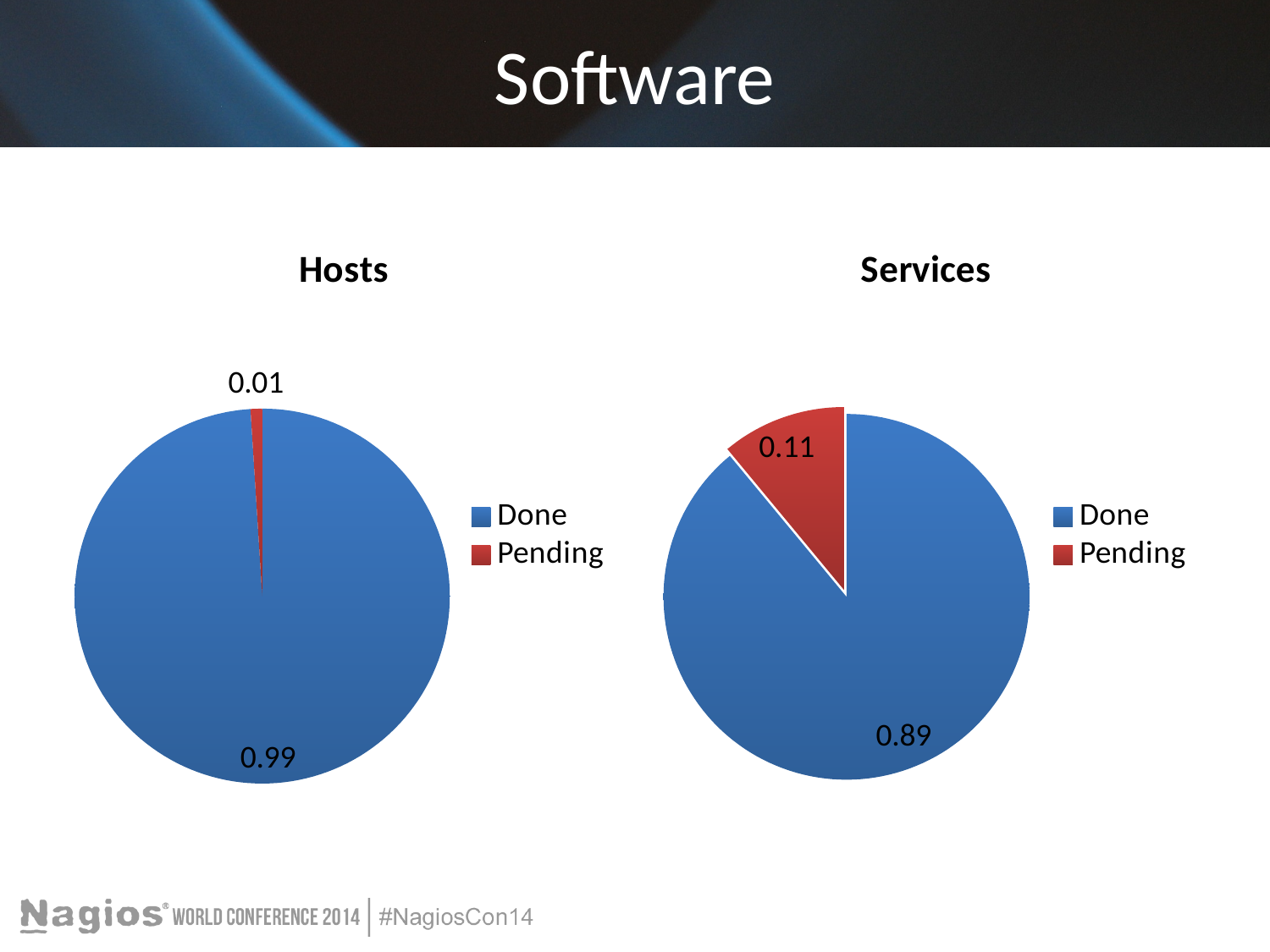
In the Services chart, what is the value for Pending? 0.11 In the Services chart, which category has the largest slice? Done What are the two legend entries in the Services chart? Done and Pending In the Services chart, what is the difference between the Done and Pending values? 0.78 Is the Pending value larger in the Hosts chart or the Services chart? Services In the Services chart, what is the value for Done? 0.89 In the Hosts chart, what is the value for Pending? 0.01 In the Hosts chart, which category has the smallest slice? Pending How many categories does the Services chart show? 2 In the Hosts chart, what is the value for Done? 0.99 In the Hosts chart, what colour is the Pending slice? Red What kind of chart is the Hosts chart? Pie chart